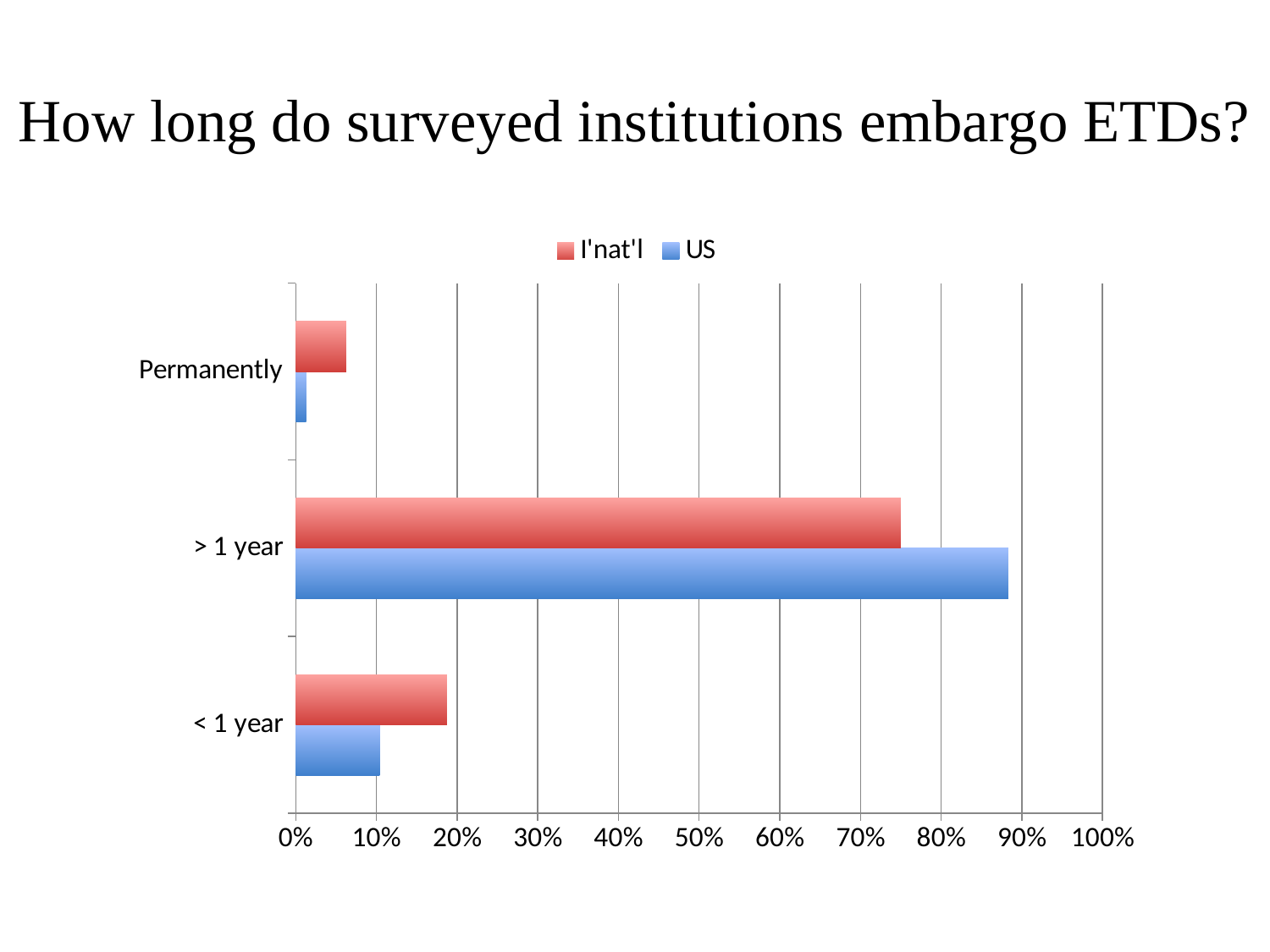
Which category has the lowest value for the I'nat'l series? Permanently Which category has the highest value for the US series? > 1 year How many series does the legend list? 2 Which category has the highest value for the I'nat'l series? > 1 year Which category has the lowest value for the US series? Permanently For the < 1 year category, which series has the larger value, I'nat'l or US? I'nat'l What kind of chart is shown on the slide? bar chart Is the I'nat'l value for < 1 year greater or less than 30%? less Is the US value for > 1 year greater or less than 80%? greater What colour are the bars for the US series? blue For the > 1 year category, which series has the larger value, I'nat'l or US? US How many categories are shown on the chart? 3